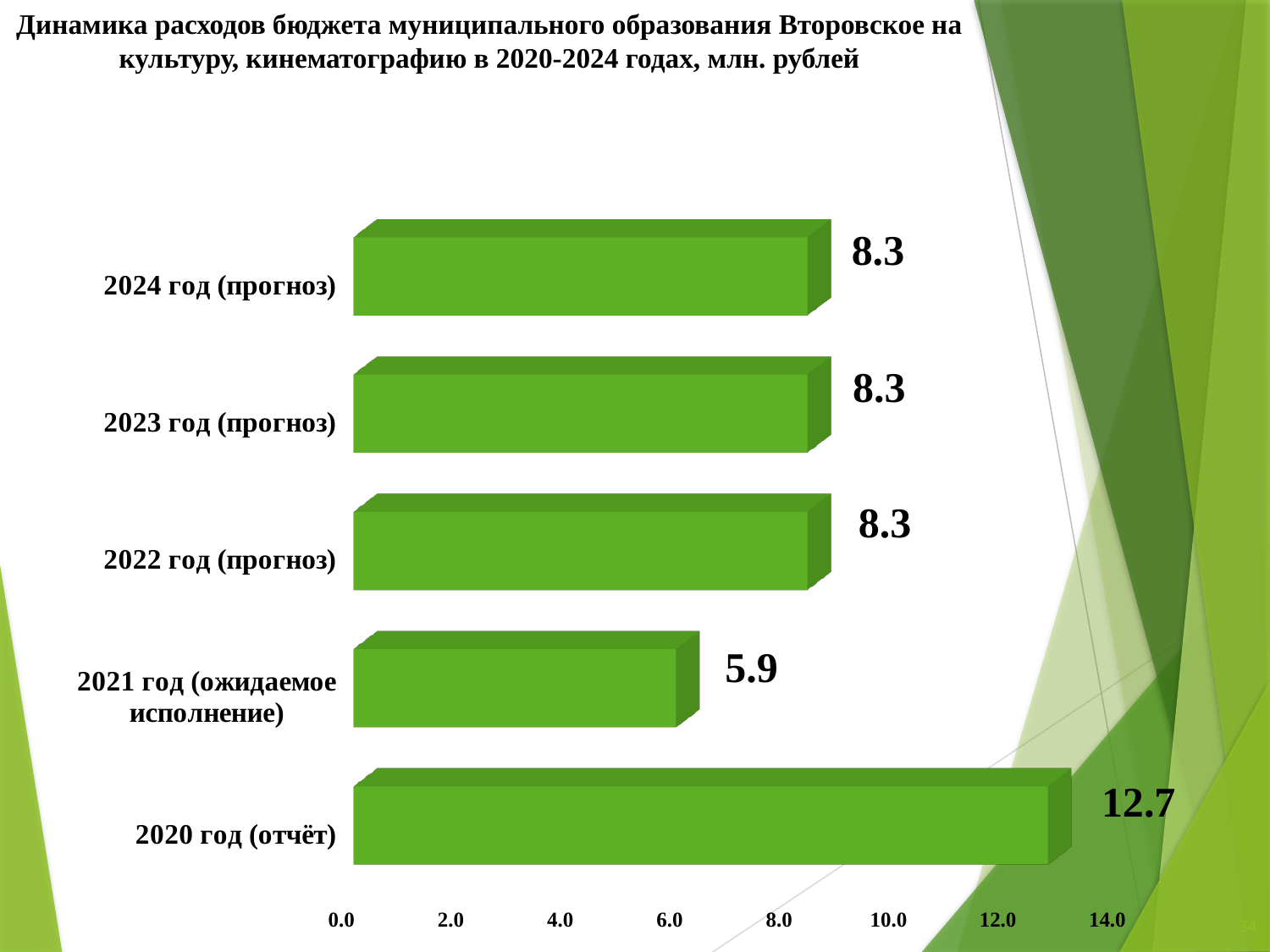
Which is larger, the value for 2020 год (отчёт) or the value for 2024 год (прогноз)? 2020 год (отчёт) Which category has the highest value? 2020 год (отчёт) Is the value for 2020 год (отчёт) greater or less than 10.0? greater Which category has the lowest value? 2021 год (ожидаемое исполнение) What is the value for 2023 год (прогноз)? 8.3 What is the difference between the values for 2020 год (отчёт) and 2021 год (ожидаемое исполнение)? 6.8 What is the difference between the values for 2022 год (прогноз) and 2021 год (ожидаемое исполнение)? 2.4 What is the maximum value shown on the horizontal axis? 14.0 What is the value for 2020 год (отчёт)? 12.7 What kind of chart is shown on the slide? bar chart What is the value for 2021 год (ожидаемое исполнение)? 5.9 How many categories are shown in the chart? 5